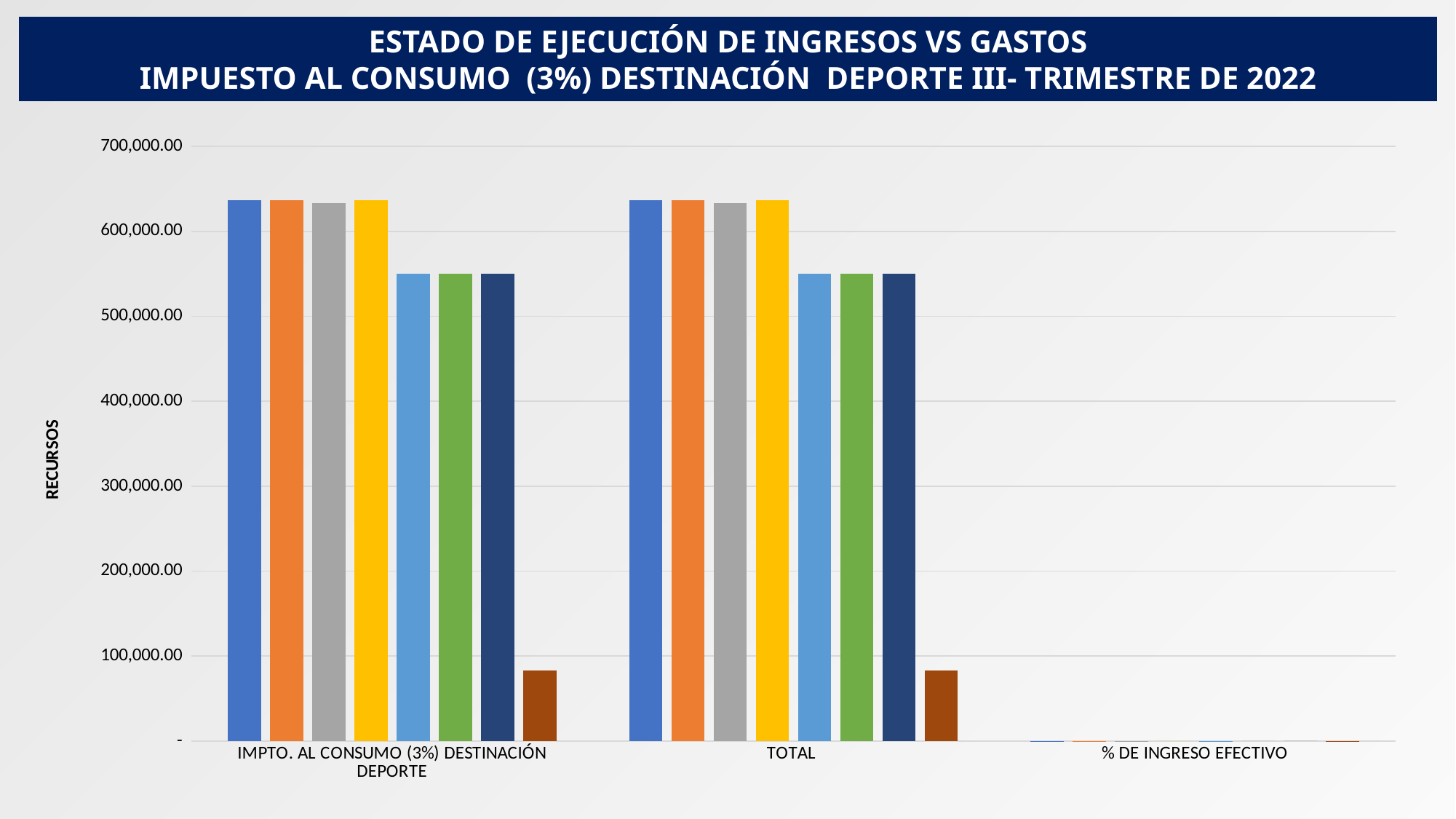
In the TOTAL category, which is larger: the yellow bar or the dark navy bar? The yellow bar Is the value of the green bar for IMPTO. AL CONSUMO (3%) DESTINACIÓN DEPORTE greater or less than 600,000.00? less Is the value of the light blue (fifth) bar for TOTAL greater or less than 500,000.00? greater In the IMPTO. AL CONSUMO (3%) DESTINACIÓN DEPORTE category, which is larger: the green bar or the brown bar? The green bar What kind of chart is shown on the slide? Bar chart What is the label of the vertical axis of the chart? RECURSOS Which category has the lowest bars in the chart? % DE INGRESO EFECTIVO Is the value of the first (blue) bar for IMPTO. AL CONSUMO (3%) DESTINACIÓN DEPORTE greater or less than 600,000.00? greater How many categories are shown on the x axis of the chart? 3 What is the title of the chart on the slide? ESTADO DE EJECUCIÓN DE INGRESOS VS GASTOS IMPUESTO AL CONSUMO (3%) DESTINACIÓN DEPORTE III- TRIMESTRE DE 2022 How many bars are plotted for the TOTAL category? 8